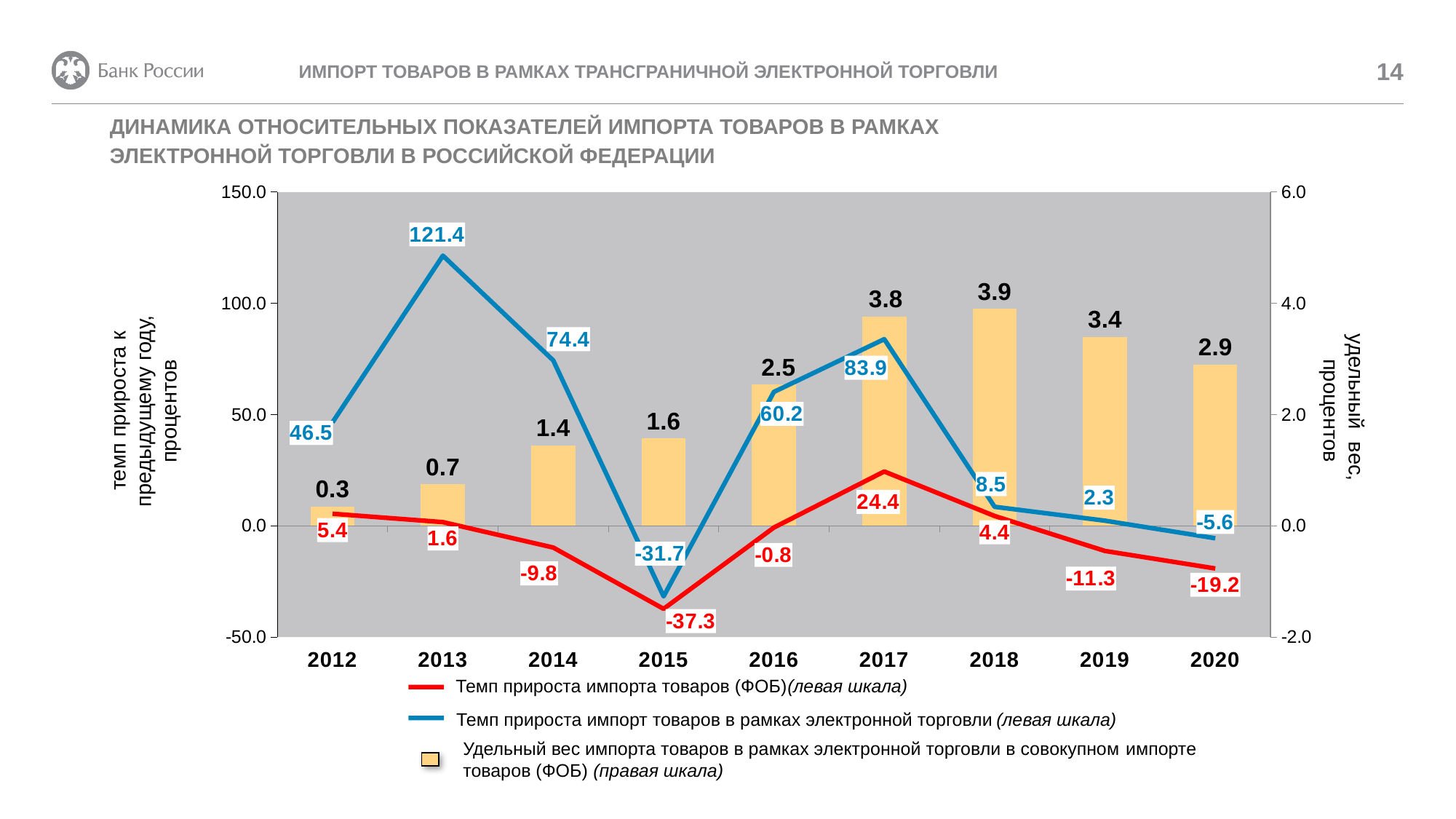
What is the value of the blue line (Темп прироста импорт товаров в рамках электронной торговли) for 2013? 121.4 What is the difference between the blue line values for 2013 and 2014? 47.0 In which year is the red line (Темп прироста импорта товаров (ФОБ)) lowest? 2015 How many years are shown on the x axis? 9 In which year is the bar series (Удельный вес) highest? 2018 Which series is plotted on the right scale (правая шкала)? Удельный вес импорта товаров в рамках электронной торговли в совокупном импорте товаров (ФОБ) How many series does the legend list? 3 Which is larger in 2017: the blue line value or the red line value? The blue line value (83.9) Does the red line (Темп прироста импорта товаров (ФОБ)) rise or fall from 2017 to 2020? Fall What kind of chart is shown on the slide? A combined bar and line chart What is the value of the red line (Темп прироста импорта товаров (ФОБ)) for 2015? -37.3 What is the value of the bar series (Удельный вес импорта товаров в рамках электронной торговли) for 2018? 3.9